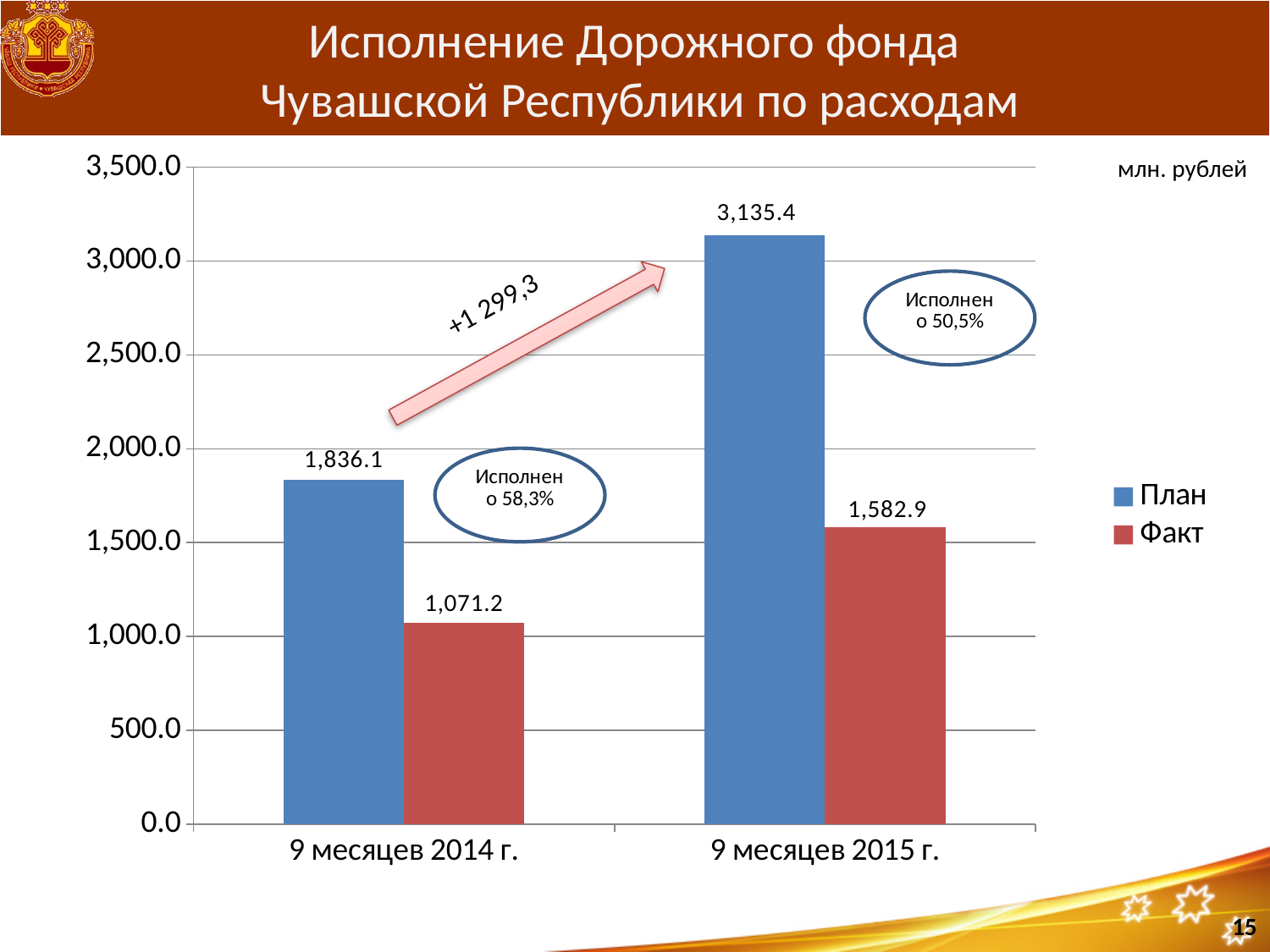
What is the difference between План and Факт for 9 месяцев 2014 г.? 764.9 By how much does the План value for 9 месяцев 2015 г. exceed the План value for 9 месяцев 2014 г.? 1,299.3 What is the Факт value for 9 месяцев 2014 г.? 1,071.2 Which bar has the highest value on the chart? План, 9 месяцев 2015 г. What is the План value for 9 месяцев 2015 г.? 3,135.4 What kind of chart is shown on the slide? Bar chart Which is larger: the Факт value for 9 месяцев 2015 г. or the План value for 9 месяцев 2014 г.? План value for 9 месяцев 2014 г. How many series does the legend list? 2 Which bar has the lowest value on the chart? Факт, 9 месяцев 2014 г. What is the План value for 9 месяцев 2014 г.? 1,836.1 What unit of measurement is indicated for the chart values? млн. рублей What is the Факт value for 9 месяцев 2015 г.? 1,582.9